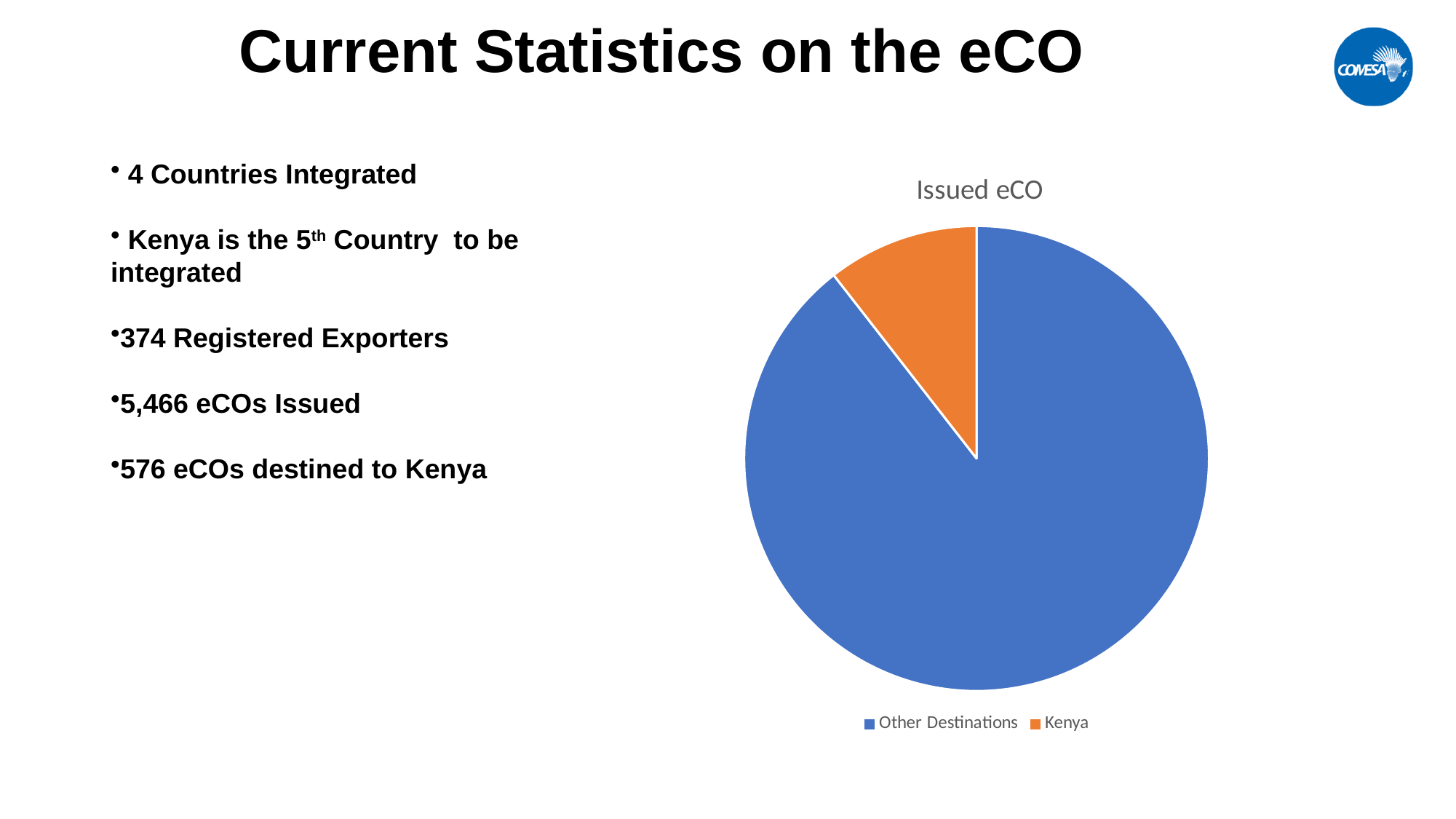
Which slice is larger, Other Destinations or Kenya? Other Destinations How many entries does the chart legend list? 2 Which category has the largest slice of the pie? Other Destinations What colour is the Kenya slice in the pie chart? Orange Which category has the smallest slice of the pie? Kenya What kind of chart is shown on the slide? Pie chart Does the Kenya slice represent more or less than half of the pie? Less What is the title of the chart? Issued eCO How many slices does the pie chart have? 2